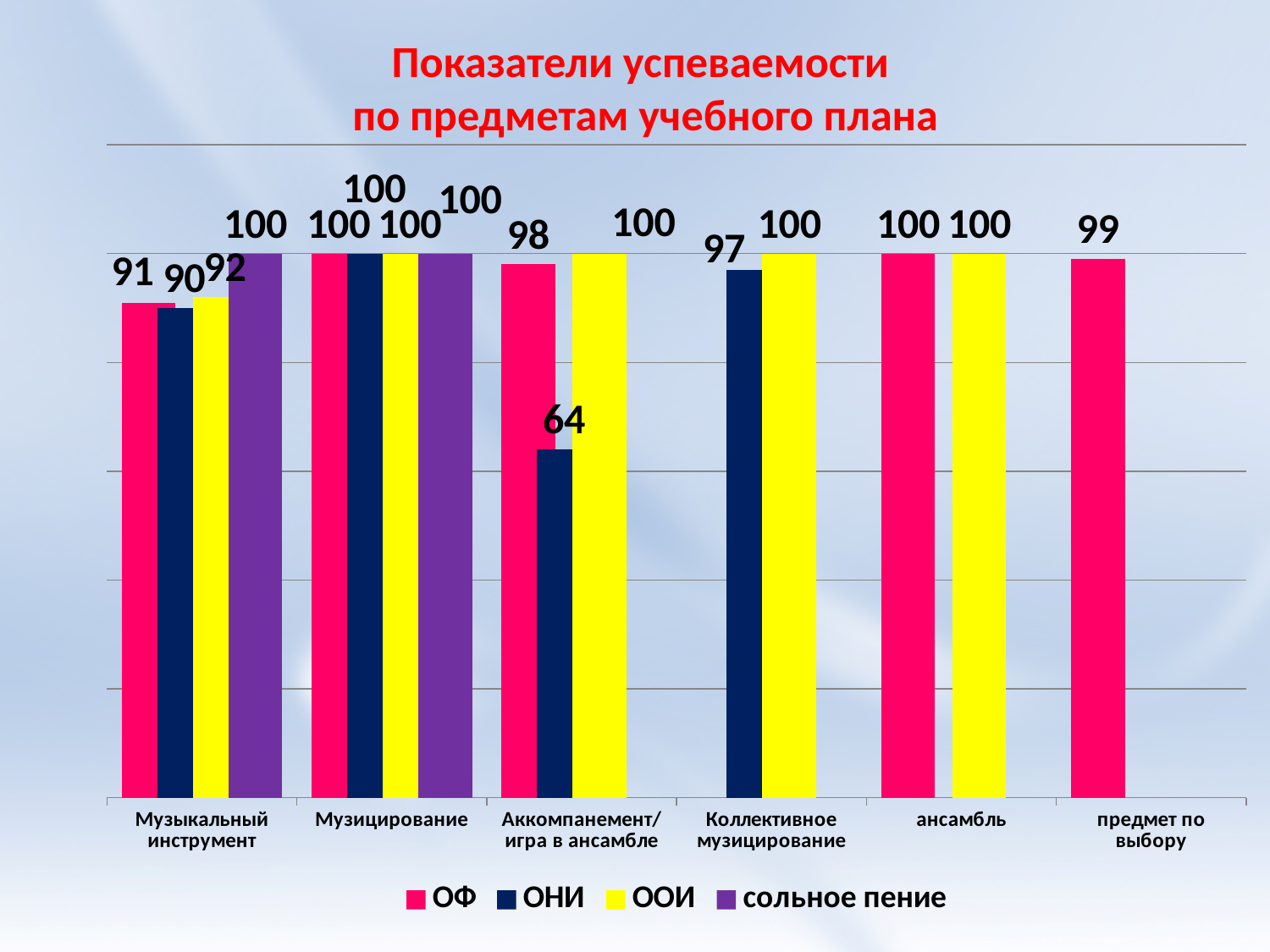
How many categories are shown on the x axis? 6 What is the value for ОФ in the Музыкальный инструмент category? 91 Which series is shown in yellow in the legend? ООИ How many series does the legend list? 4 What is the value for ОФ in the предмет по выбору category? 99 What is the difference between the ОФ and ОНИ values in the Аккомпанемент/игра в ансамбле category? 34 What is the value for ООИ in the Музыкальный инструмент category? 92 What kind of chart is shown on the slide? bar chart Which is larger in the Музыкальный инструмент category: the ОФ value or the ООИ value? ООИ What is the value for ОНИ in the Коллективное музицирование category? 97 What is the value for ОНИ in the Аккомпанемент/игра в ансамбле category? 64 Which series has the lowest value in the Музыкальный инструмент category? ОНИ